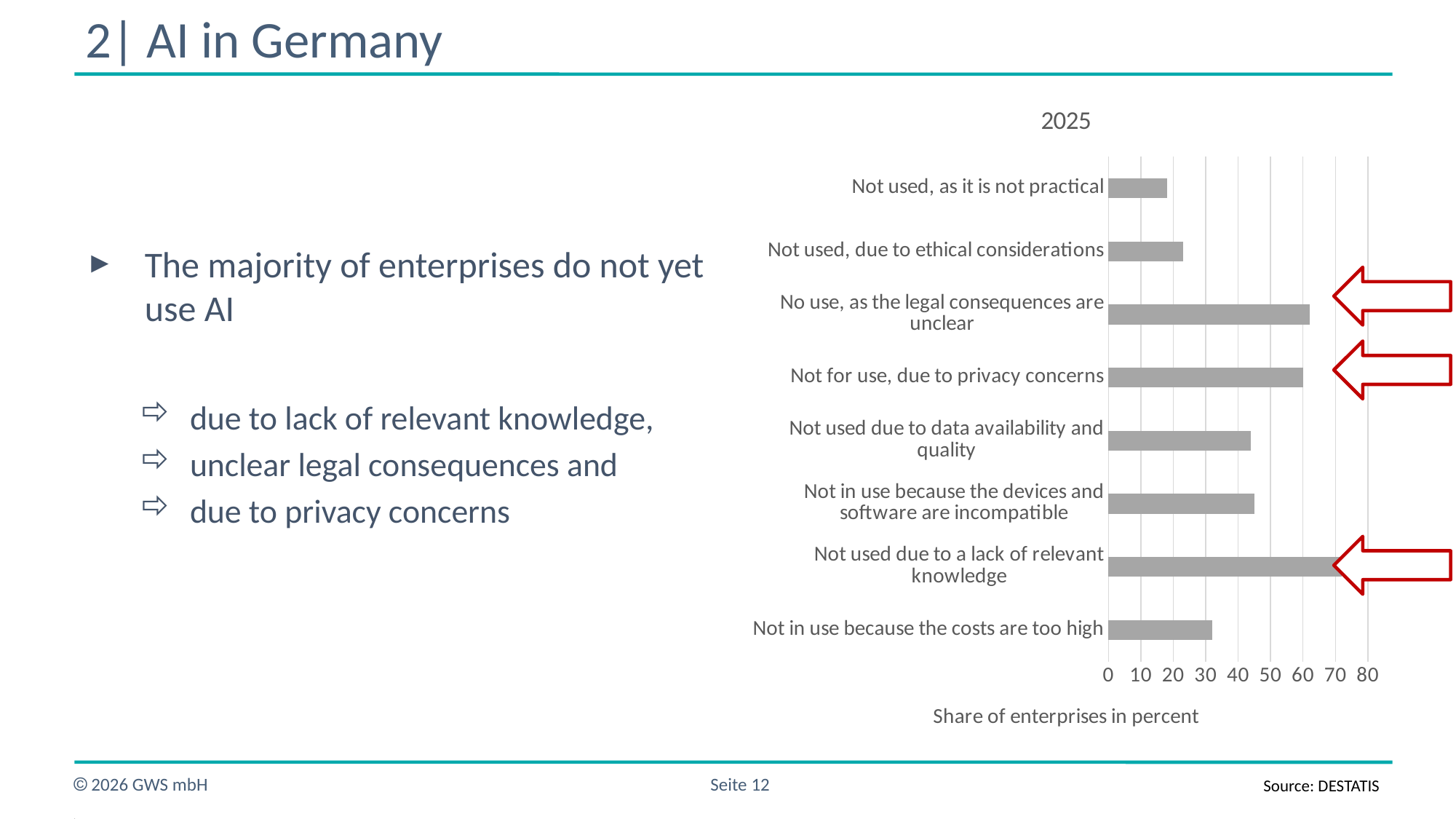
Which category has the highest share of enterprises in the chart? Not used due to a lack of relevant knowledge Is the value for "Not used due to a lack of relevant knowledge" greater or less than 60? greater Which category has the lowest share of enterprises in the chart? Not used, as it is not practical Which is larger: the value for "Not used, due to ethical considerations" or the value for "Not for use, due to privacy concerns"? Not for use, due to privacy concerns What kind of chart is shown on the slide? bar chart Which is larger: the value for "Not used due to a lack of relevant knowledge" or the value for "Not in use because the costs are too high"? Not used due to a lack of relevant knowledge What is the title of the chart? 2025 Is the value for "No use, as the legal consequences are unclear" greater or less than 50? greater Is the value for "Not in use because the costs are too high" greater or less than 40? less What is the label of the horizontal axis of the chart? Share of enterprises in percent How many categories (reasons) are plotted in the chart? 8